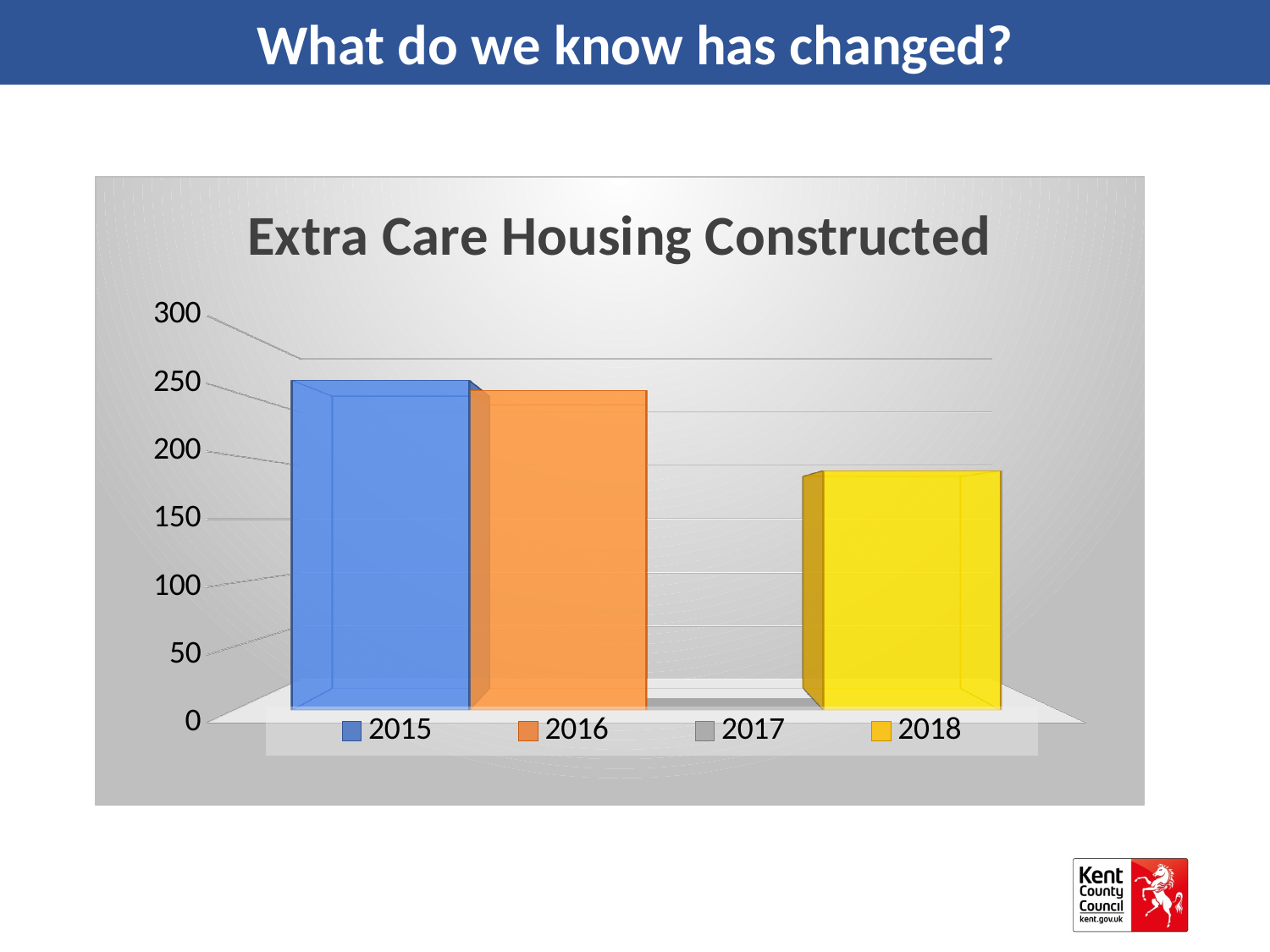
Is the value for 2016 greater or less than 200? greater Is the value for 2018 greater or less than 150? greater Is the value for 2015 greater or less than 200? greater Which is larger, the value for 2015 or the value for 2018? 2015 Which is larger, the value for 2016 or the value for 2018? 2016 How many series does the legend list? 4 What colour is the bar for 2018? yellow What is the title of the chart? Extra Care Housing Constructed What kind of chart is shown on the slide? bar chart Of the years with a visible bar, which has the lowest value? 2018 Do the values generally rise or fall from 2015 to 2018? fall